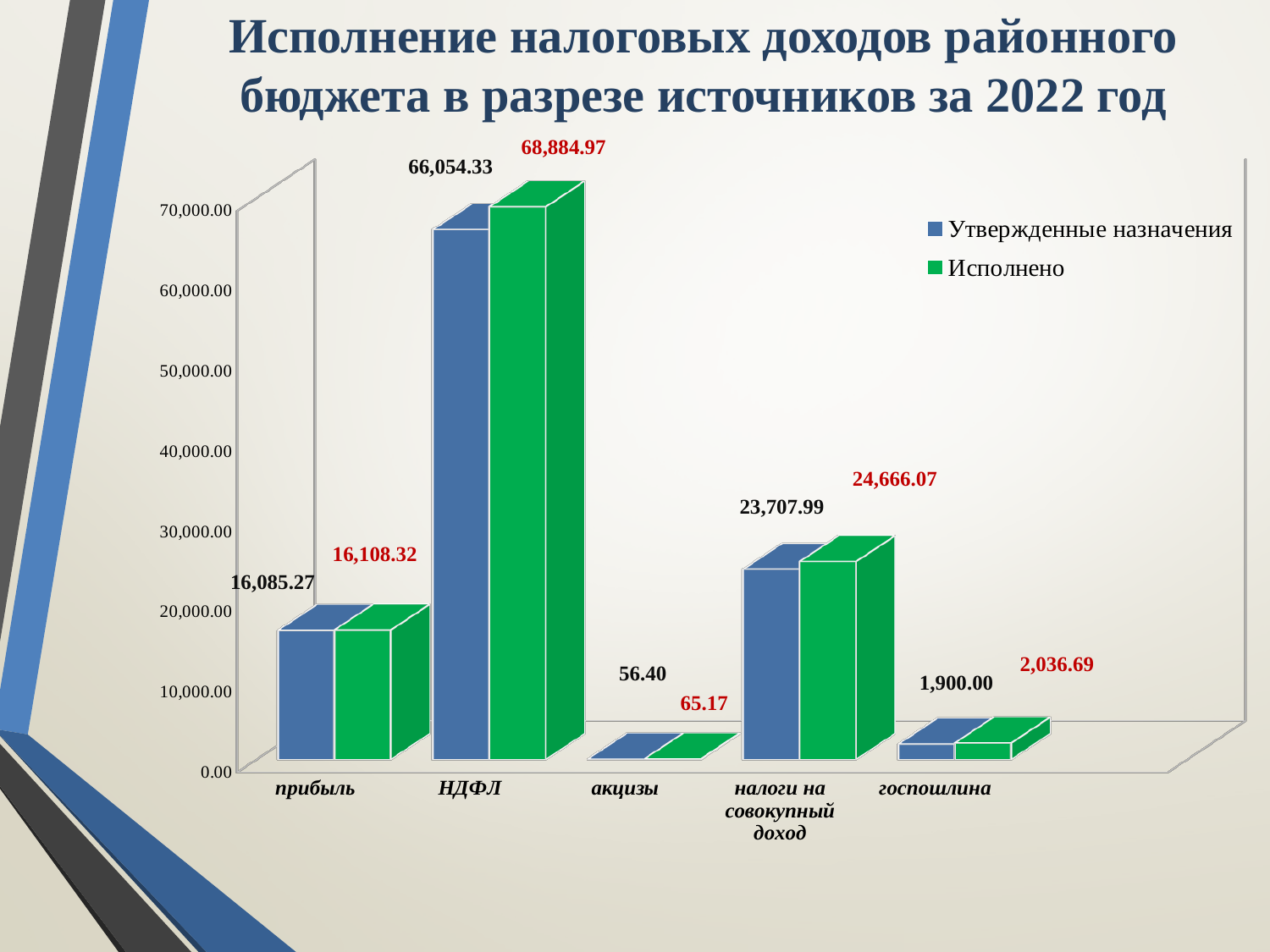
Which category has the highest Исполнено value? НДФЛ How many series does the legend list? 2 What is the value of Утвержденные назначения for акцизы? 56.40 What is the difference between Исполнено and Утвержденные назначения for НДФЛ? 2,830.64 What is the value of Исполнено for НДФЛ? 68,884.97 How many categories are shown on the x axis? 5 Which is larger for прибыль: Утвержденные назначения or Исполнено? Исполнено What is the value of Утвержденные назначения for налоги на совокупный доход? 23,707.99 Which category has the lowest Утвержденные назначения value? акцизы What kind of chart is shown on the slide? Bar chart What is the difference between Исполнено and Утвержденные назначения for налоги на совокупный доход? 958.08 What is the value of Исполнено for госпошлина? 2,036.69